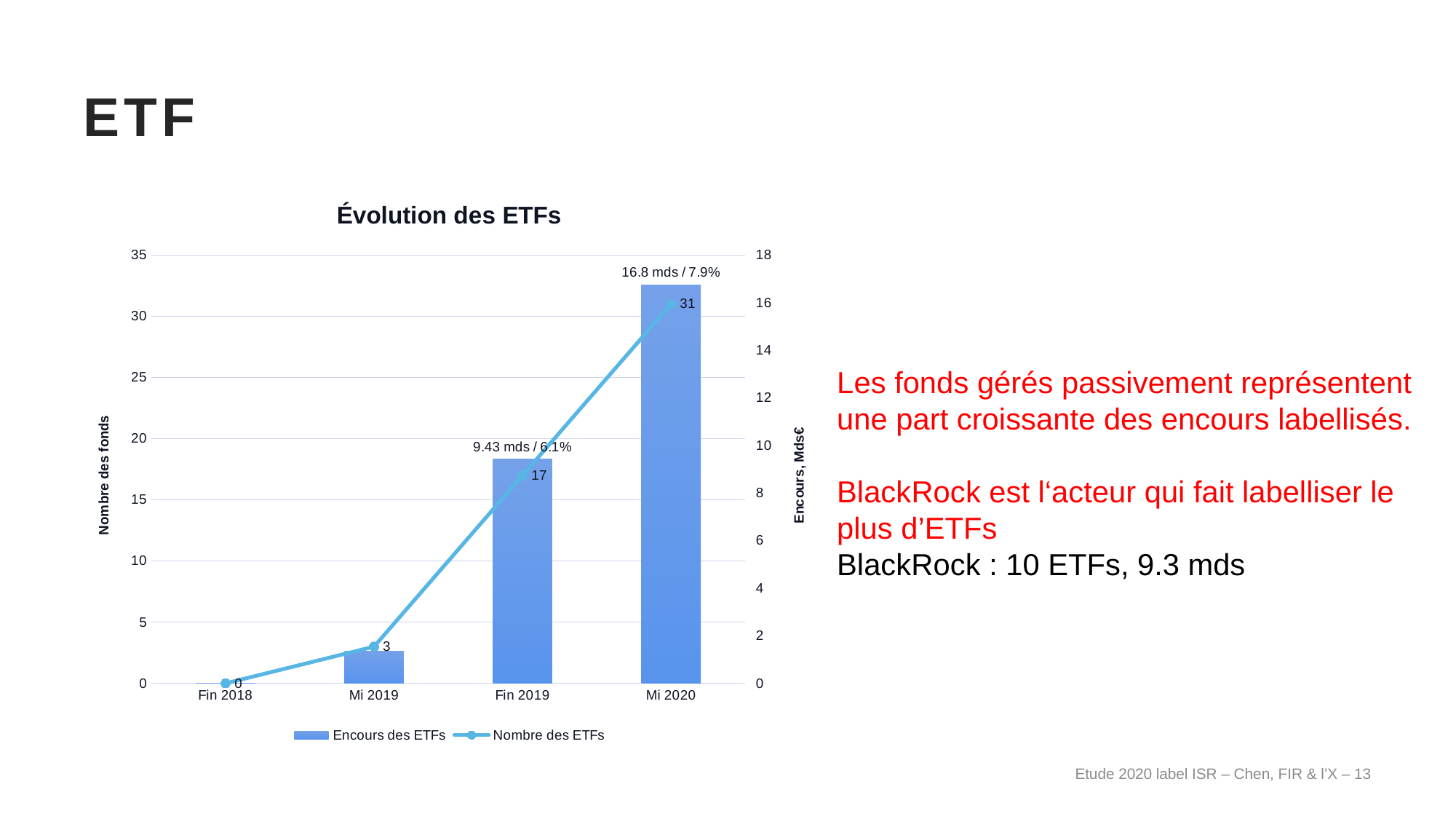
How many series does the legend list? 2 What data label is shown on the Encours des ETFs bar for Mi 2020? 16.8 mds / 7.9% What is the value of Nombre des ETFs at Mi 2020? 31 What data label is shown on the Encours des ETFs bar for Fin 2019? 9.43 mds / 6.1% Which period has the lowest Nombre des ETFs? Fin 2018 What is the value of Nombre des ETFs at Fin 2019? 17 Does Nombre des ETFs rise or fall from Fin 2018 to Mi 2020? rise How many periods are shown on the x axis of the chart? 4 Which period has the highest Nombre des ETFs? Mi 2020 Is the Encours des ETFs value for Mi 2019 greater or less than 2 on the right axis? less By how much did Nombre des ETFs increase from Fin 2019 to Mi 2020? 14 What is the value of Nombre des ETFs at Mi 2019? 3